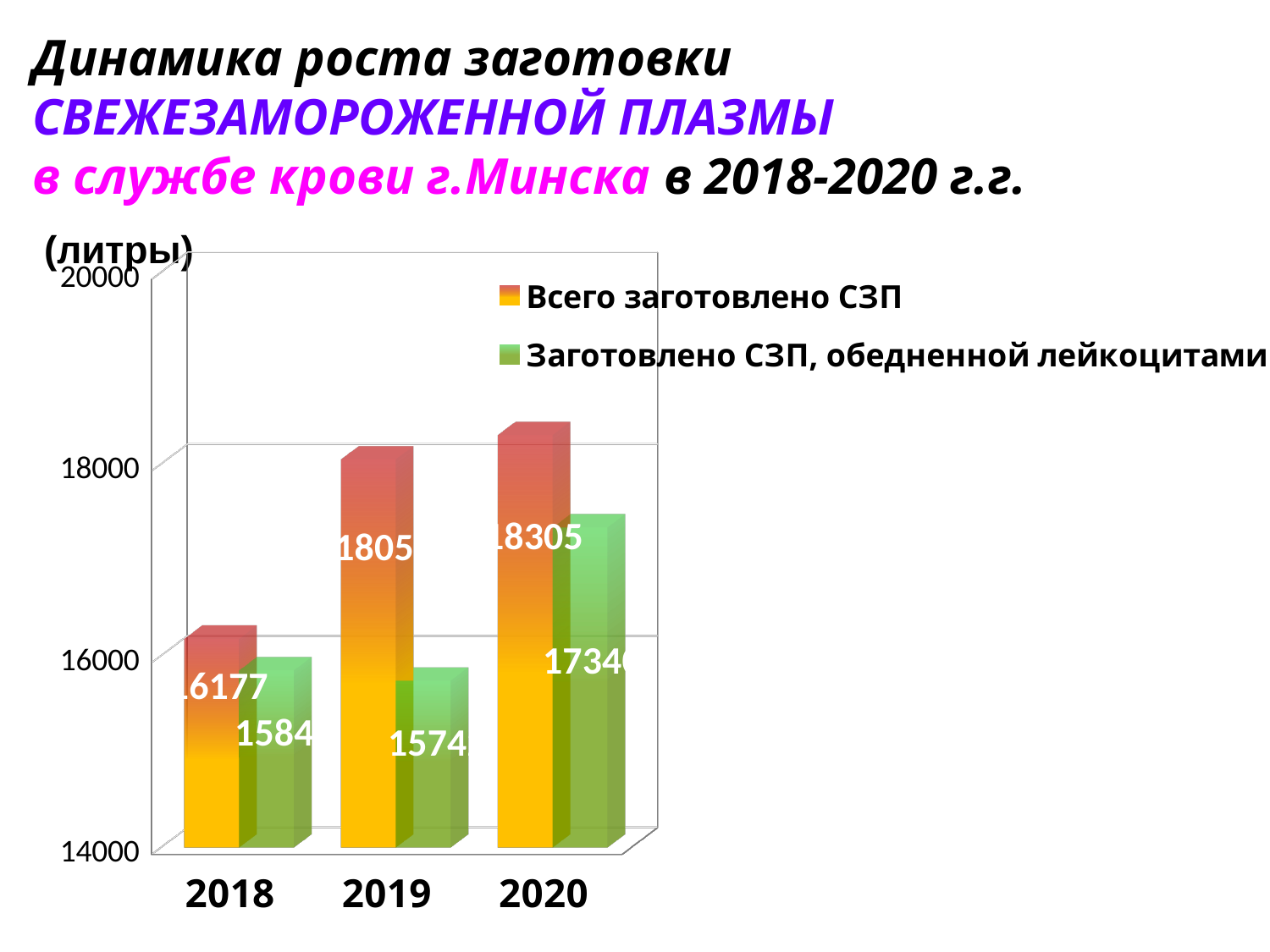
Is the value of "Заготовлено СЗП, обедненной лейкоцитами" for 2019 greater or less than 16000? less How many series does the legend list? 2 What is the value of "Всего заготовлено СЗП" for 2020? 18305 Does "Всего заготовлено СЗП" rise or fall from 2018 to 2020? rise In which year is "Всего заготовлено СЗП" the highest? 2020 What is the difference between "Всего заготовлено СЗП" in 2020 and in 2018? 2128 How many years are shown on the x axis? 3 Is the value of "Заготовлено СЗП, обедненной лейкоцитами" for 2020 greater or less than 16000? greater What is the value of "Всего заготовлено СЗП" for 2018? 16177 In which year is "Всего заготовлено СЗП" the lowest? 2018 What type of chart is shown on the slide? bar chart In which year is "Заготовлено СЗП, обедненной лейкоцитами" the highest? 2020